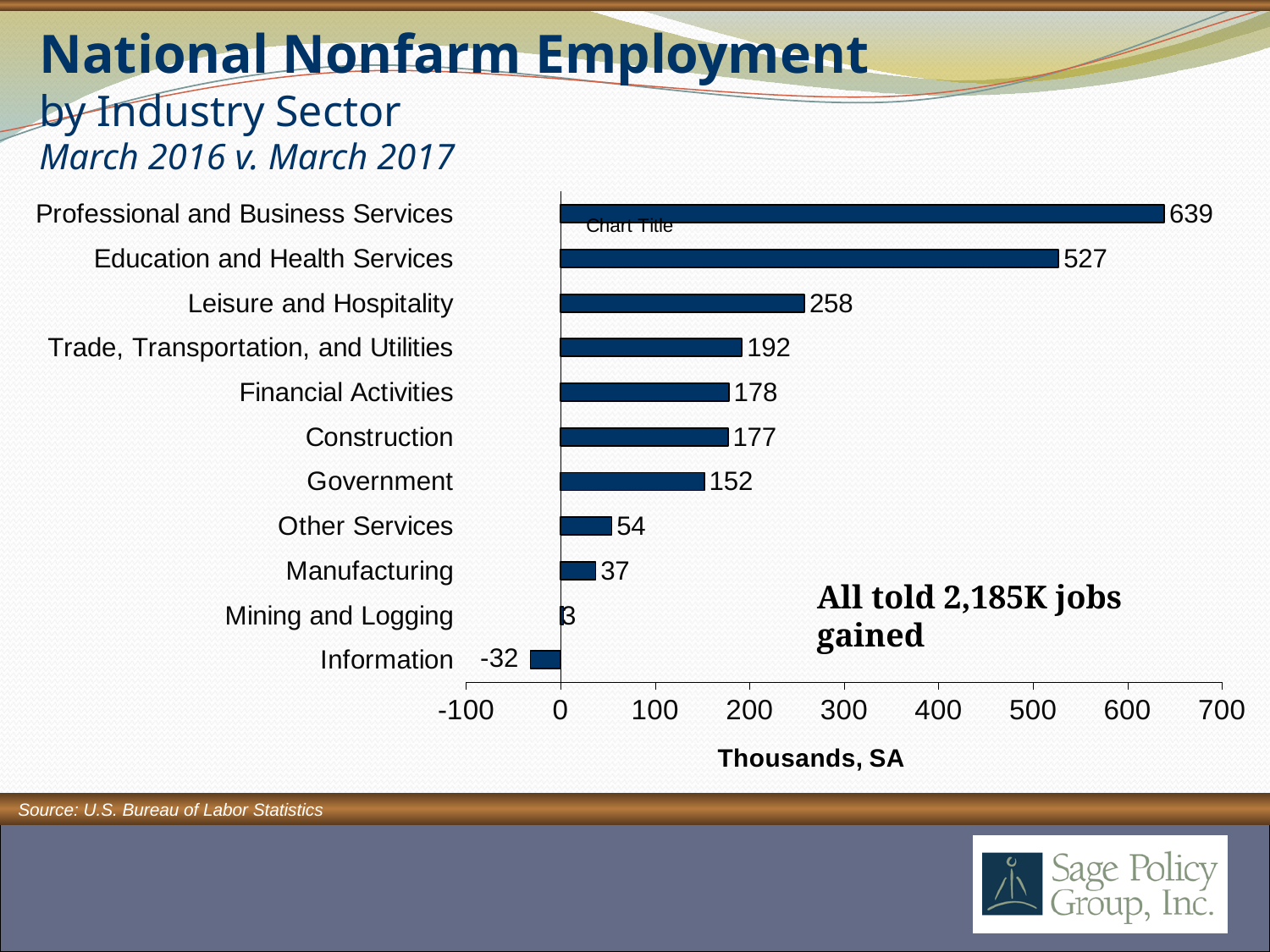
Which industry sector has the lowest value? Information What is the difference between the values for Professional and Business Services and Education and Health Services? 112 What is the value for Information? -32 What kind of chart is shown on the slide? bar chart What is the label on the horizontal axis of the chart? Thousands, SA Which is larger, the value for Leisure and Hospitality or the value for Trade, Transportation, and Utilities? Leisure and Hospitality Is the value for Leisure and Hospitality greater or less than 200? greater Which industry sector has the highest value? Professional and Business Services What is the value for Education and Health Services? 527 How many industry sectors are shown in the chart? 11 What is the value for Professional and Business Services? 639 What is the value for Government? 152